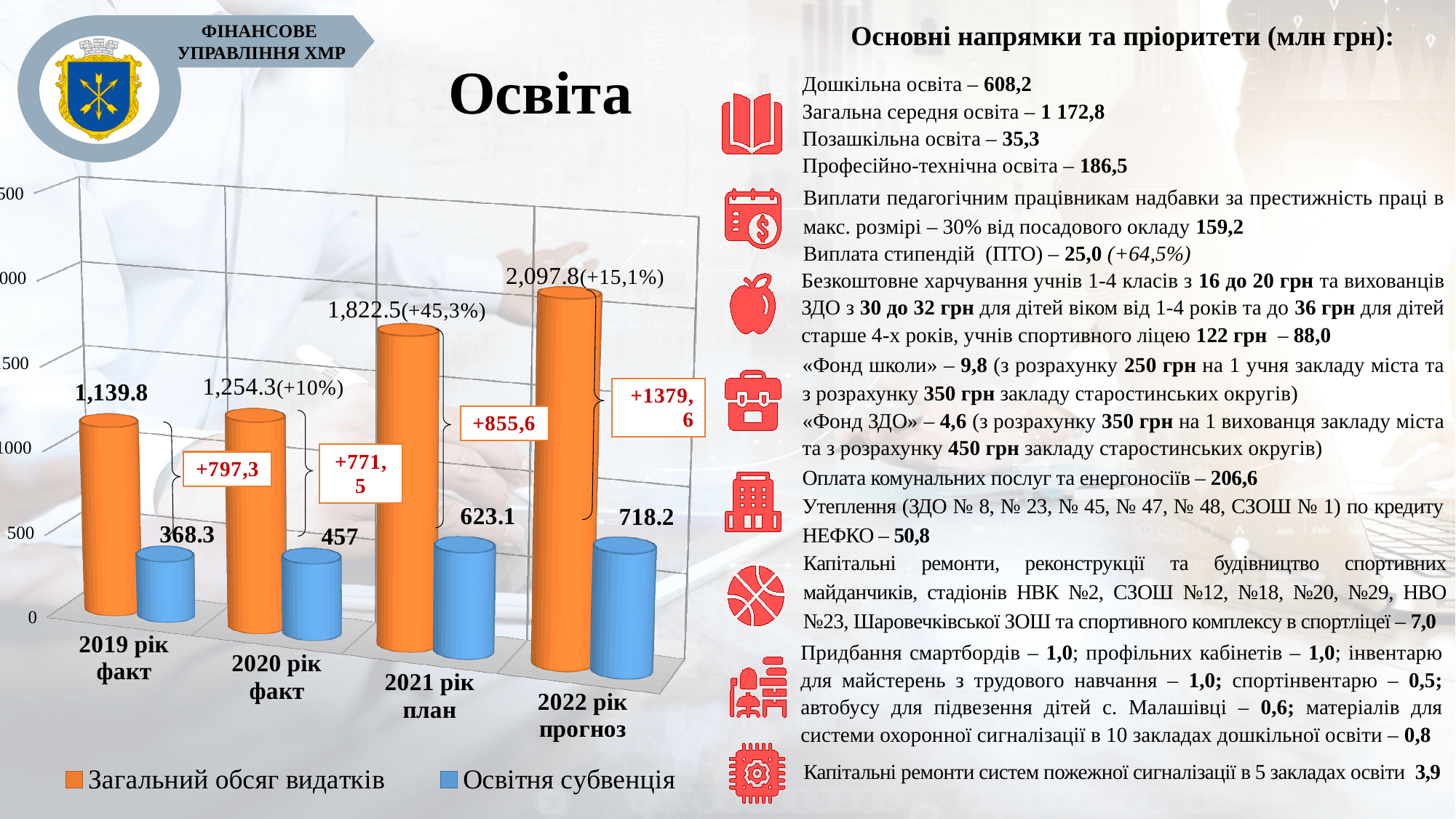
What is the value of Освітня субвенція for 2021 рік план? 623.1 What is the value of Загальний обсяг видатків for 2019 рік факт? 1,139.8 What is the value of Освітня субвенція for 2020 рік факт? 457 How many categories are shown on the x axis of the chart? 4 Which is larger: Освітня субвенція for 2021 рік план or for 2022 рік прогноз? 2022 рік прогноз How many series does the chart legend list? 2 Which category has the highest value for Загальний обсяг видатків? 2022 рік прогноз Which category has the lowest value for Освітня субвенція? 2019 рік факт What is the value of Загальний обсяг видатків for 2022 рік прогноз? 2,097.8 What is the difference between Загальний обсяг видатків and Освітня субвенція for 2022 рік прогноз? 1379.6 Do the values of Загальний обсяг видатків rise or fall from 2019 рік факт to 2022 рік прогноз? Rise What kind of chart is shown on the slide? Bar chart